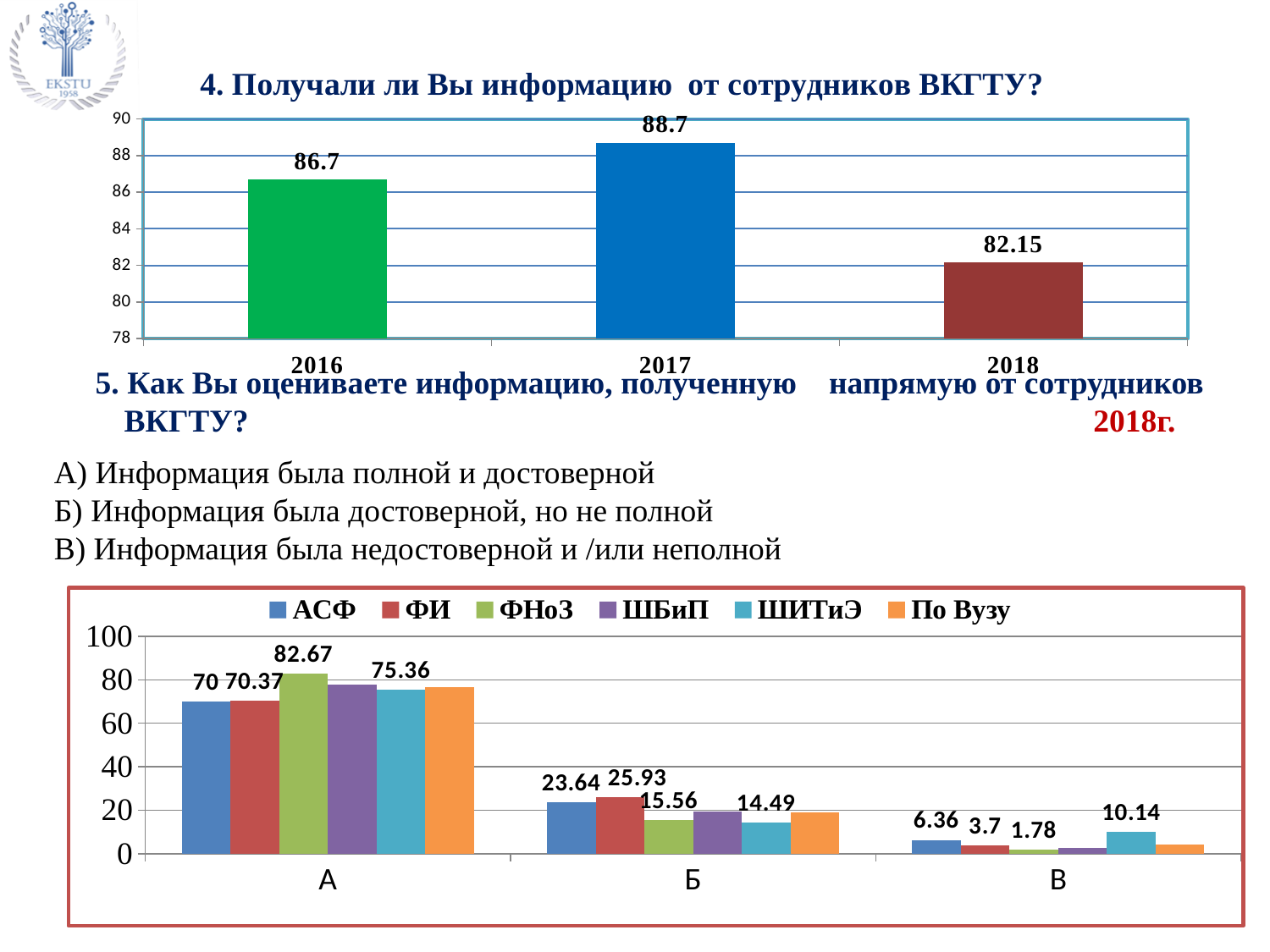
In the bottom chart, what is the value for ФНоЗ in category А? 82.67 In the bottom chart, what is the value for ФИ in category Б? 25.93 In the top chart '4. Получали ли Вы информацию от сотрудников ВКГТУ?', which year has the highest value? 2017 In the top chart '4. Получали ли Вы информацию от сотрудников ВКГТУ?', what is the value for 2018? 82.15 In the top chart '4. Получали ли Вы информацию от сотрудников ВКГТУ?', what is the value for 2017? 88.7 What kind of chart is the bottom chart? Bar chart In the top chart '4. Получали ли Вы информацию от сотрудников ВКГТУ?', how many years are shown? 3 In the top chart '4. Получали ли Вы информацию от сотрудников ВКГТУ?', what is the difference between the 2017 and 2016 values? 2 In the top chart '4. Получали ли Вы информацию от сотрудников ВКГТУ?', which year has the lowest value? 2018 In the bottom chart, what is the value for АСФ in category В? 6.36 In the bottom chart, which is larger in category Б: АСФ or ФНоЗ? АСФ In the bottom chart, how many series does the legend list? 6